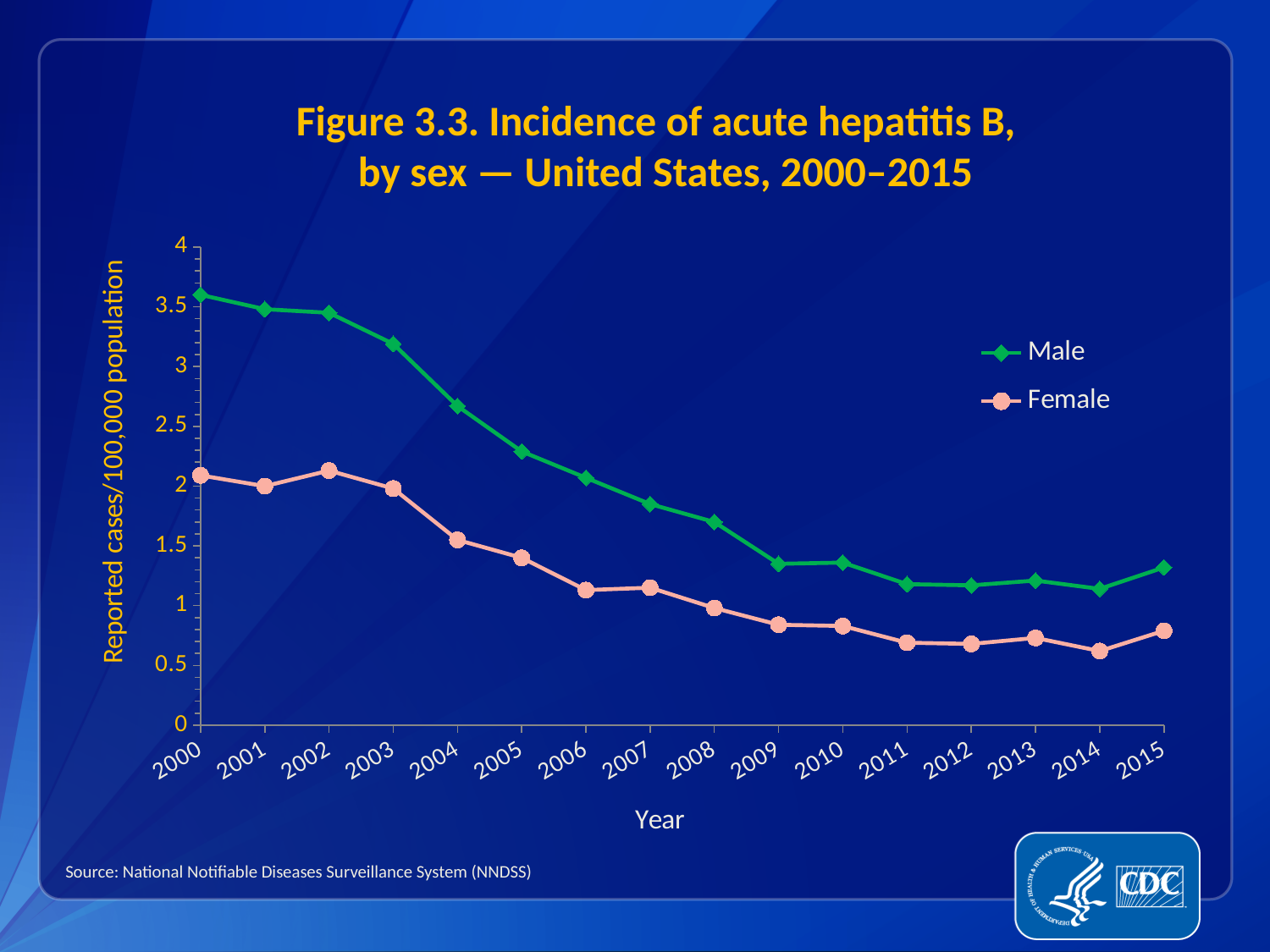
How many years are plotted along the x axis? 16 Is the Male value for 2004 greater or less than 2.5? greater Overall, do the Male incidence values rise or fall from 2000 to 2015? Fall Is the Female value for 2014 greater or less than 1? less Is the Male value for 2003 greater or less than 3? greater In 2005, which series has the higher incidence rate, Male or Female? Male How many series does the legend list? 2 What is the label on the y axis? Reported cases/100,000 population In which year is the Male incidence rate highest? 2000 What kind of chart is shown on the slide? Line chart